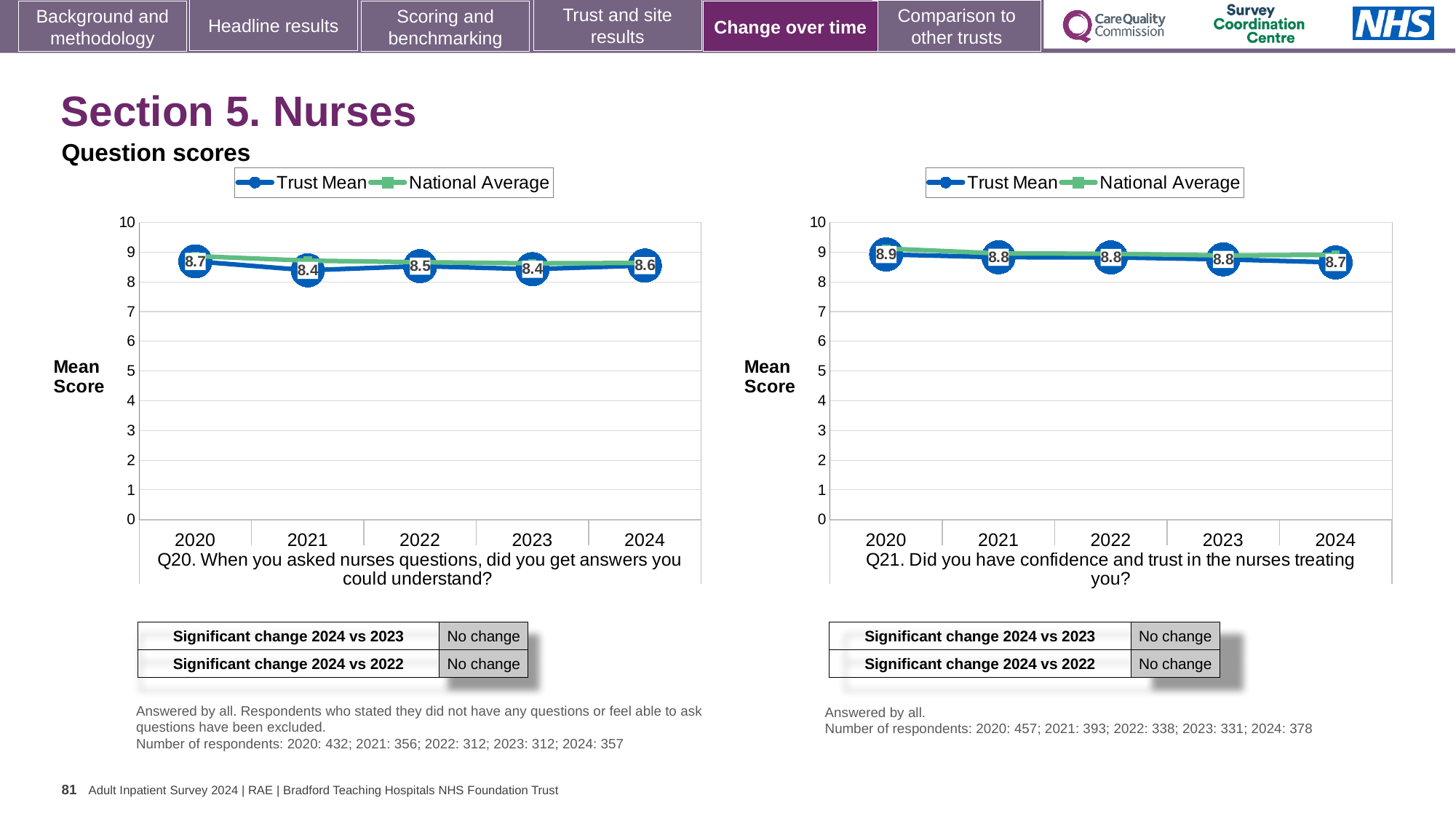
On the Q20 chart (left), which year has the highest Trust Mean score? 2020 On the Q20 chart (left), what is the difference between the Trust Mean scores for 2020 and 2021? 0.3 On the Q20 chart (left), how many years are plotted on the x axis? 5 On the Q21 chart (right), is the Trust Mean score for 2020 greater or less than 8? greater On the Q20 chart (left), what is the Trust Mean score for 2024? 8.6 On the Q21 chart (right), how many series does the legend list? 2 On the Q21 chart (right), what is the Trust Mean score for 2020? 8.9 What type of chart is the Q20 chart on the left? Line chart On the Q21 chart (right), which year has the lowest Trust Mean score? 2024 On the Q20 chart (left), what is the Trust Mean score for 2020? 8.7 On the Q21 chart (right), what is the Trust Mean score for 2024? 8.7 On the Q21 chart (right), does the Trust Mean score rise or fall from 2020 to 2024? Fall